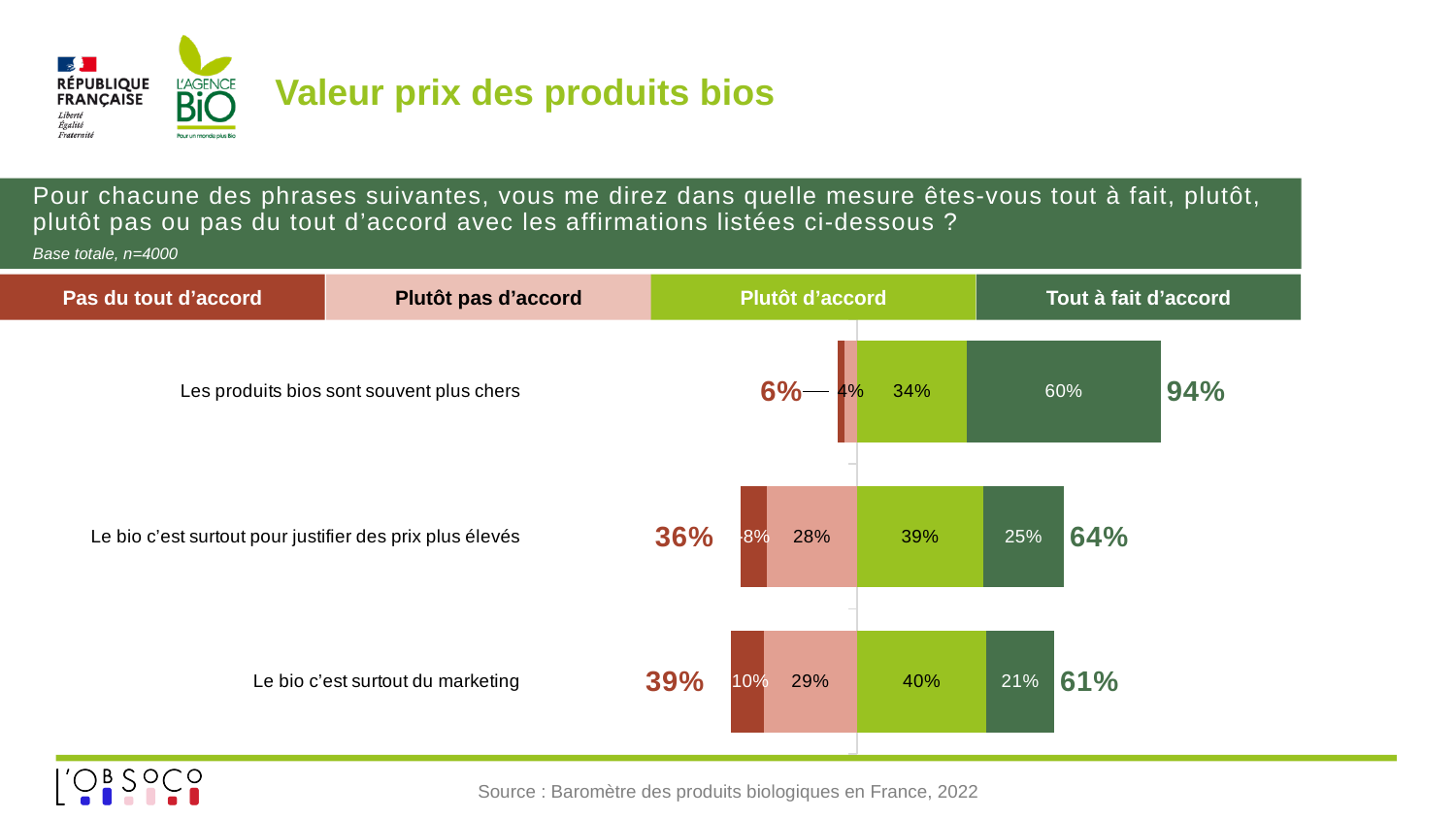
What is the total agreement (Plutôt d'accord plus Tout à fait d'accord) shown for 'Le bio c'est surtout pour justifier des prix plus élevés'? 64% Which statement has the highest 'Tout à fait d'accord' value? Les produits bios sont souvent plus chers How many response categories does the legend list? 4 What kind of chart is shown on the slide? stacked bar chart What is the 'Plutôt d'accord' value for 'Le bio c'est surtout du marketing'? 40% How many statements (categories) are plotted in the chart? 3 Which statement has the lowest total agreement (Plutôt d'accord + Tout à fait d'accord)? Le bio c'est surtout du marketing What is the 'Pas du tout d'accord' value for 'Le bio c'est surtout du marketing'? 10% What is the 'Tout à fait d'accord' value for 'Les produits bios sont souvent plus chers'? 60% Which is larger: the 'Plutôt d'accord' value for 'Le bio c'est surtout du marketing' or for 'Les produits bios sont souvent plus chers'? Le bio c'est surtout du marketing What is the 'Plutôt pas d'accord' value for 'Le bio c'est surtout pour justifier des prix plus élevés'? 28% What is the difference between the 'Tout à fait d'accord' values for 'Le bio c'est surtout pour justifier des prix plus élevés' and 'Le bio c'est surtout du marketing'? 4%